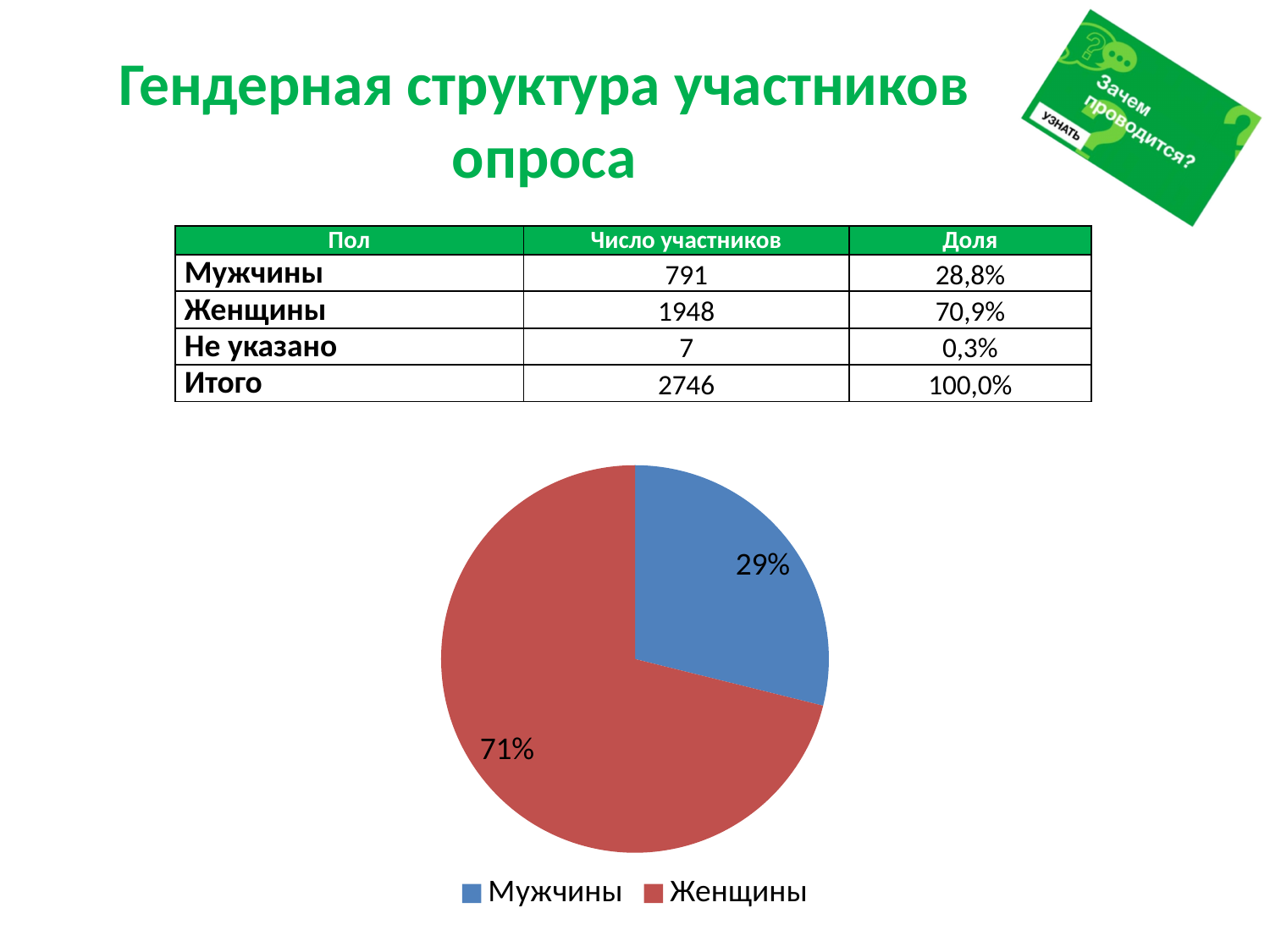
Which slice of the pie chart is the smallest? Мужчины Which slice is larger in the pie chart, Мужчины or Женщины? Женщины What colour is the Женщины slice in the pie chart? red What is the difference in percentage points between the Женщины and Мужчины slices in the pie chart? 42 Which slice of the pie chart is the largest? Женщины Is the share for Женщины in the pie chart greater or less than 50%? greater What kind of chart is shown on the slide? pie chart What colour is the Мужчины slice in the pie chart? blue What share of the pie chart is labelled for Мужчины? 29% How many entries does the legend of the pie chart list? 2 What share of the pie chart is labelled for Женщины? 71% How many slices does the pie chart have? 2